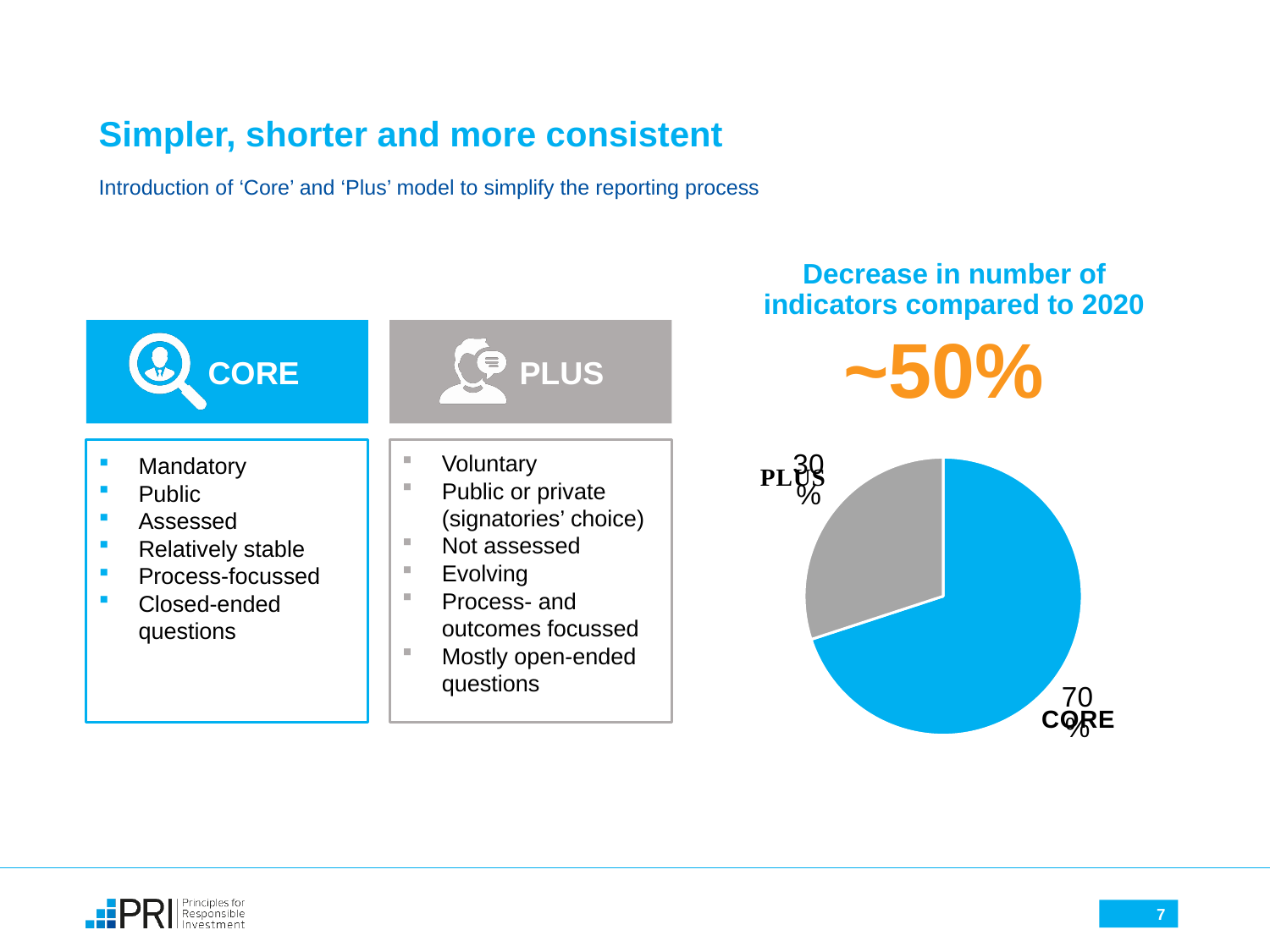
Which slice of the pie chart is the smallest? PLUS What kind of chart is shown on the right of the slide? Pie chart Which slice of the pie chart is the largest? CORE What share of the pie chart does CORE represent? 70% What share of the pie does the CORE slice take up? 70% What share of the pie chart does PLUS represent? 30% What colour is the CORE slice in the pie chart? Blue What colour is the PLUS slice in the pie chart? Grey In the pie chart, which is larger, CORE or PLUS? CORE In the pie chart, what is the difference in percentage points between the CORE and PLUS slices? 40 percentage points How many slices does the pie chart have? 2